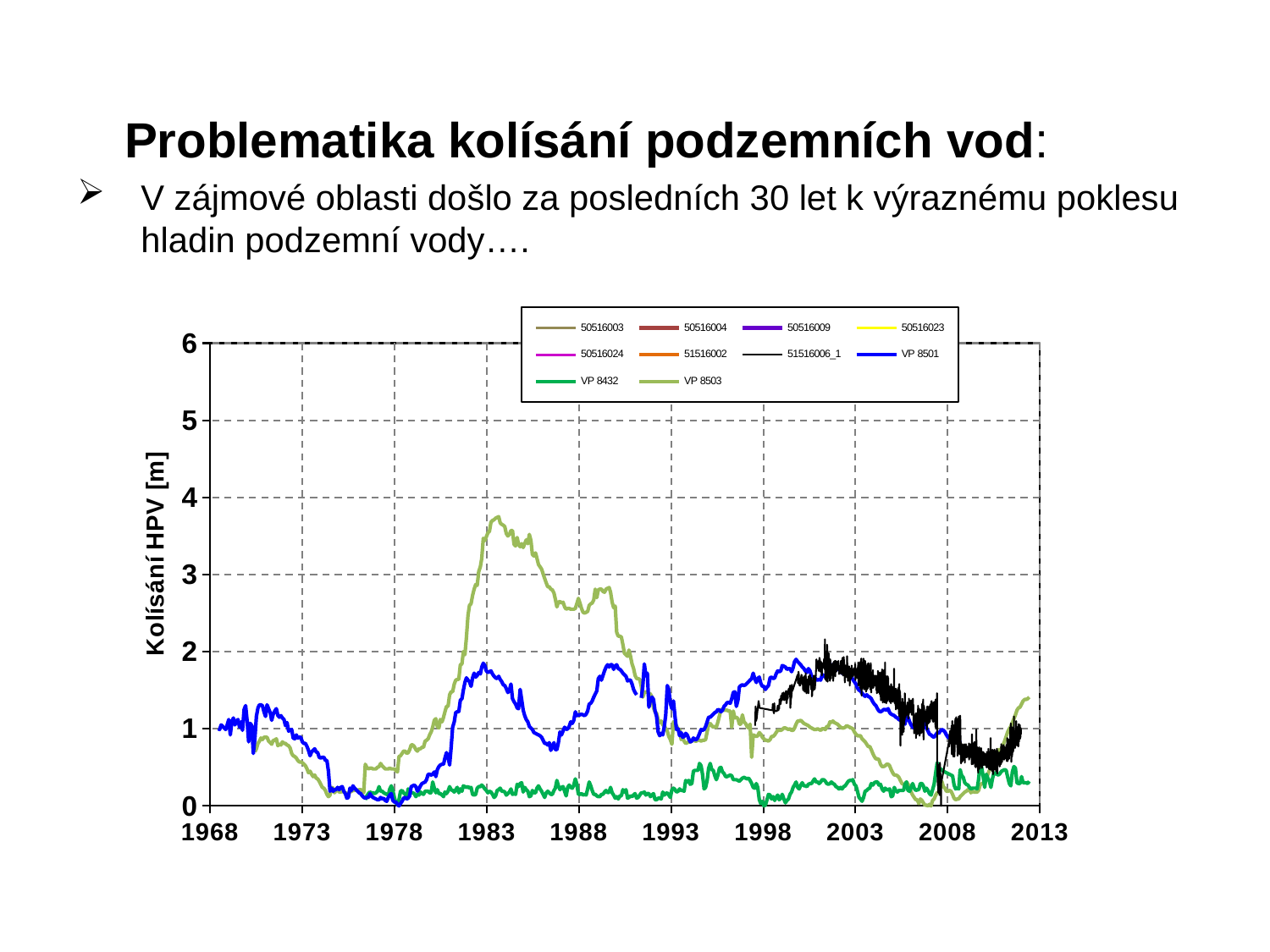
Does the VP 8501 line rise or fall between 2003 and 2008? fall Around 1983, which is larger: the value for VP 8503 or the value for VP 8432? VP 8503 What kind of chart is shown on the slide? line chart Is the value for VP 8501 around 1978 greater or less than 1? less Is the value for VP 8432 around 1988 greater or less than 1? less How many series does the legend list? 10 What is the label of the vertical axis? Kolísání HPV [m] What colour is the line for VP 8501? blue Is the value for VP 8501 around 1983 greater or less than 1? greater Which series reaches the highest value anywhere on the chart? VP 8503